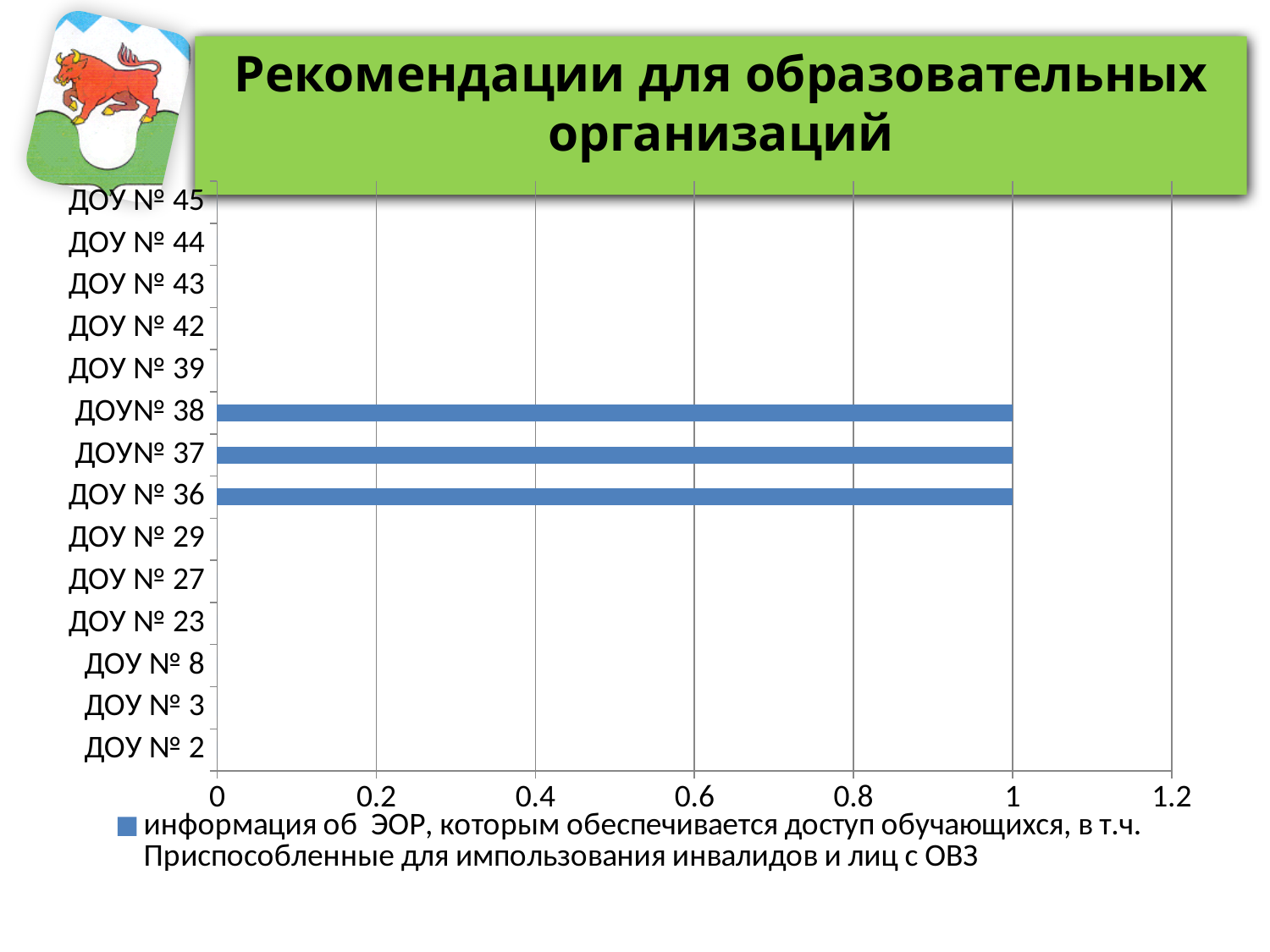
What is the value for ДОУ № 36 in the chart? 1 What kind of chart is shown on the slide? bar chart Which categories in the chart have a visible bar? ДОУ № 36, ДОУ№ 37, ДОУ№ 38 How many categories (ДОУ) are listed on the vertical axis of the chart? 14 Which is larger in the chart, the value for ДОУ № 36 or the value for ДОУ № 29? ДОУ № 36 How many categories in the chart have a visible bar? 3 Is the value for ДОУ № 36 greater or less than 0.8? greater What is the highest value shown on the horizontal axis of the chart? 1.2 What is the value for ДОУ№ 38 in the chart? 1 What is the value for ДОУ№ 37 in the chart? 1 How many series does the chart legend list? 1 Is the value for ДОУ№ 38 greater or less than 1.2? less